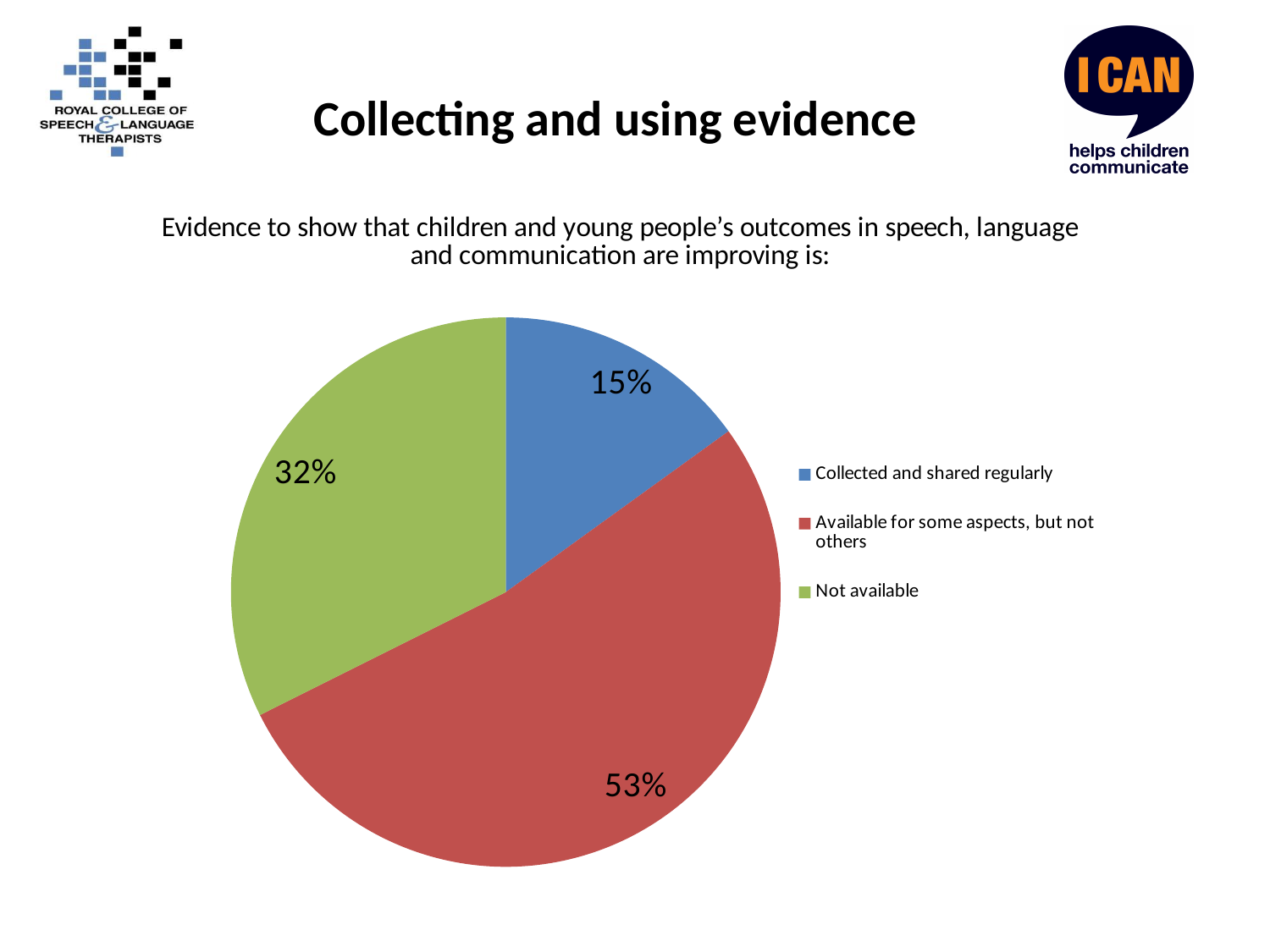
What percentage of the pie is 'Collected and shared regularly'? 15% What colour is the slice for 'Not available'? green What is the difference in percentage points between 'Not available' and 'Collected and shared regularly'? 17 What kind of chart is shown on the slide? pie chart What percentage of the pie is 'Available for some aspects, but not others'? 53% What is the title of the slide containing the pie chart? Collecting and using evidence Which category has the smallest share of the pie? Collected and shared regularly Which is larger: the share for 'Not available' or the share for 'Collected and shared regularly'? Not available How many categories does the pie chart have? 3 What is the difference in percentage points between 'Available for some aspects, but not others' and 'Not available'? 21 What percentage of the pie is 'Not available'? 32% Which category has the largest share of the pie? Available for some aspects, but not others